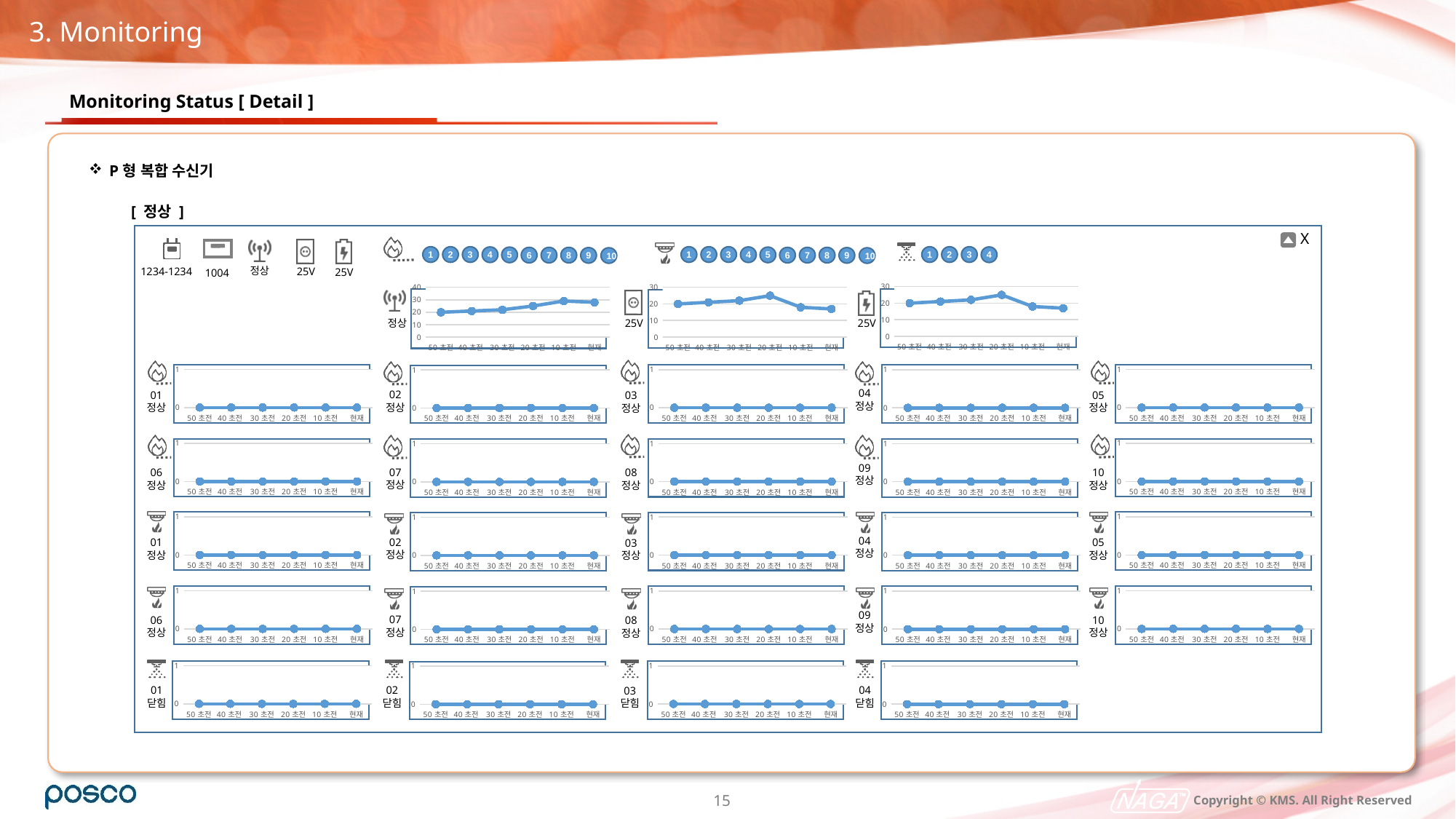
On the top-middle line chart (next to the 25V plug icon), which is larger: the value at 20 초전 or the value at 현재? 20 초전 What is the last x-axis label on the top-left line chart (next to the 정상 signal icon)? 현재 On the top-right line chart (next to the 25V battery icon), which x-axis point has the highest value? 20 초전 How many data points are plotted on the top-left line chart (next to the 정상 signal icon)? 6 On the top-left line chart (next to the 정상 signal icon), is the value at 현재 greater or less than 20? greater What is the value at 현재 on the small chart labelled 01 정상 in the first row of small charts? 0 On the top-middle line chart (next to the 25V plug icon), which x-axis point has the highest value? 20 초전 What is the highest y-axis tick shown on the top-left line chart (next to the 정상 signal icon)? 40 What kind of chart is the top-left chart next to the signal icon labelled 정상? line chart On the top-left line chart (next to the 정상 signal icon), is the value at 50 초전 greater or less than 30? less On the top-left line chart (next to the 정상 signal icon), do the values rise or fall from 50 초전 to 현재? rise On the top-right line chart (next to the 25V battery icon), is the value at 현재 greater or less than 20? less